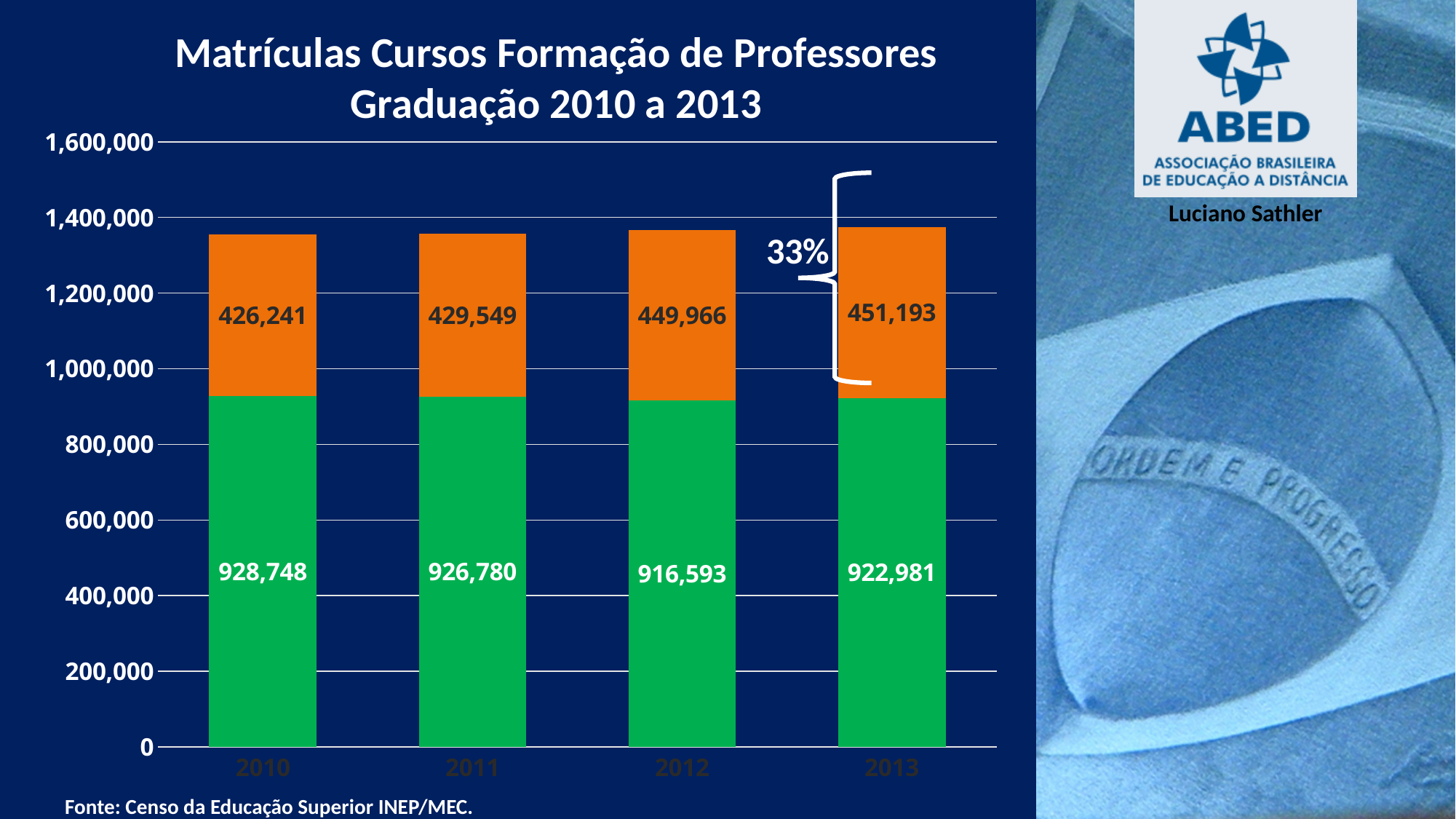
Which year has the highest value for the orange segment? 2013 What is the value of the green segment for 2010? 928,748 What is the value of the orange segment for 2012? 449,966 How many years are shown on the x axis? 4 What is the total of the stacked bar for 2013? 1,374,174 What is the value of the green segment for 2011? 926,780 Is the green segment value larger in 2010 or in 2013? 2010 Which year has the lowest value for the green segment? 2012 What percentage is annotated next to the orange segment of the 2013 bar? 33% What is the difference between the orange segment values for 2013 and 2010? 24,952 What type of chart is shown on the slide? Stacked bar chart What is the value of the orange segment for 2013? 451,193